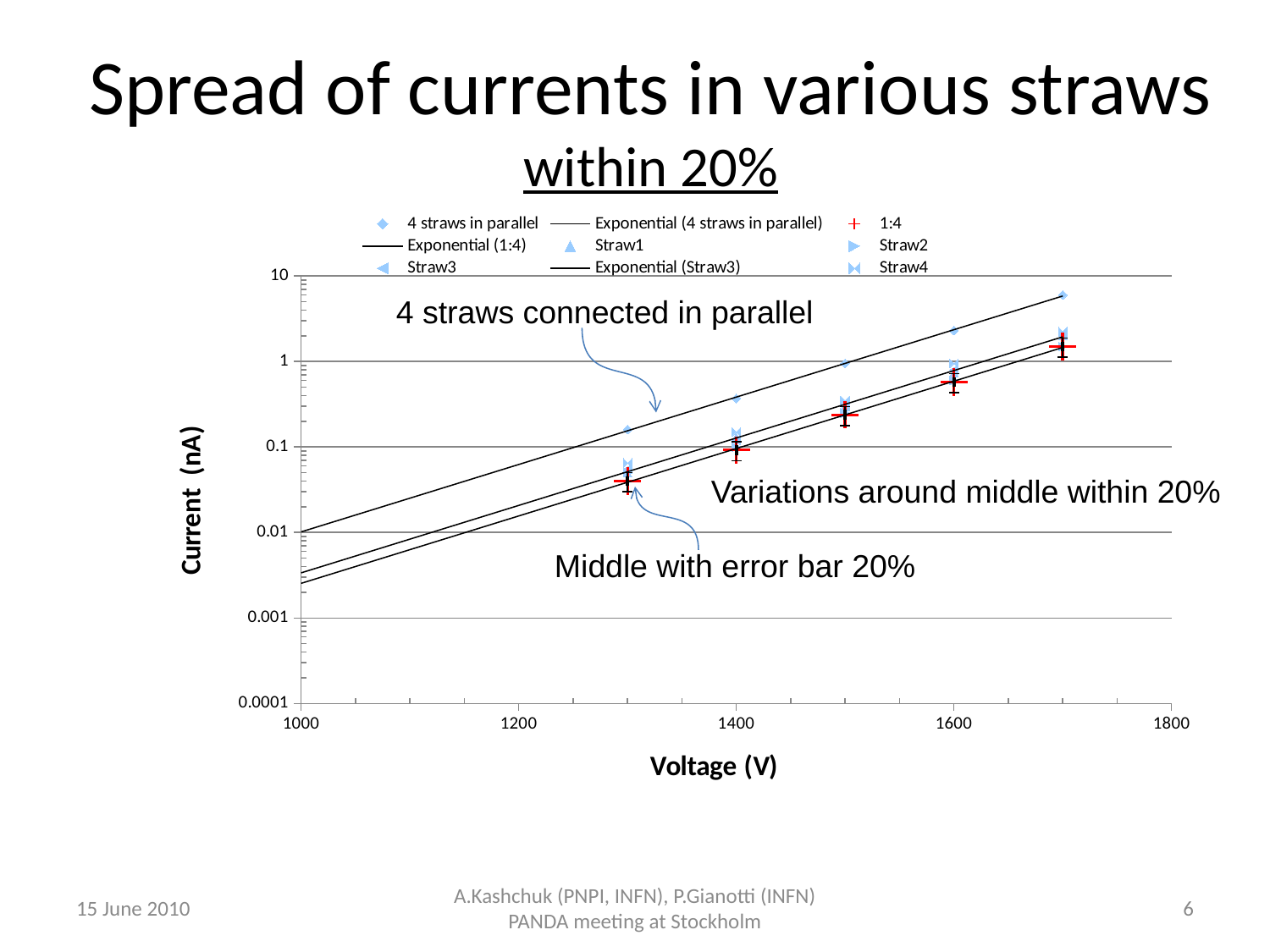
How many voltage points are plotted for the '4 straws in parallel' series? 5 Is the current for '4 straws in parallel' at 1700 V greater or less than 1? greater What kind of chart is shown on the slide? scatter chart At 1500 V, which series has the higher current: '4 straws in parallel' or '1:4'? 4 straws in parallel What is the title of the y axis of the chart? Current (nA) Is the current for '4 straws in parallel' at 1300 V greater or less than 0.1? greater At which voltage does the '4 straws in parallel' series reach its highest current? 1700 What is the title of the x axis of the chart? Voltage (V) How many entries does the chart legend list? 9 Is the current for '1:4' at 1500 V greater or less than 1? less Does the current rise or fall as the voltage increases along the x axis? rise